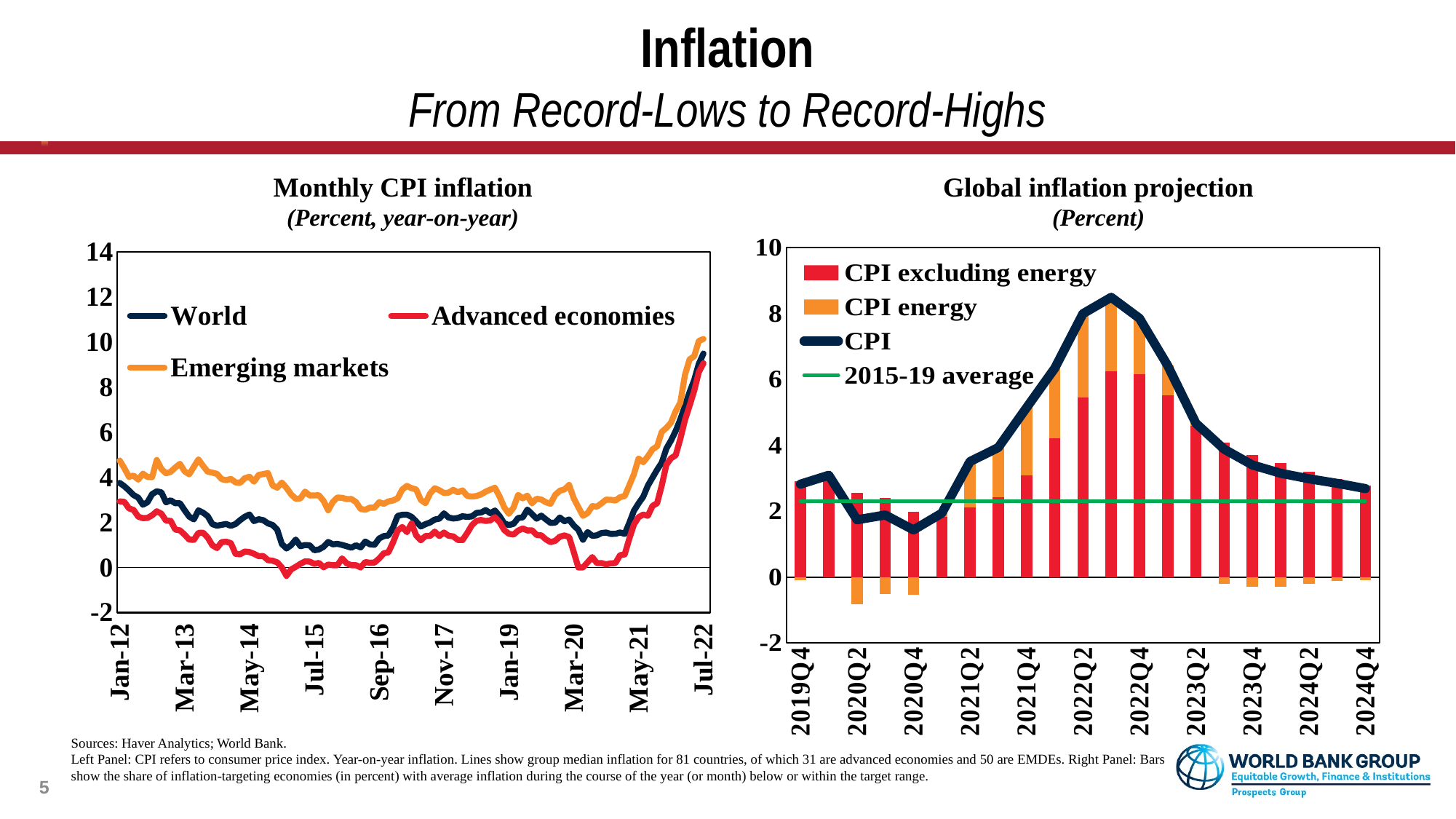
What kind of chart is the left chart, 'Monthly CPI inflation'? line chart In the left chart, 'Monthly CPI inflation', do the lines rise or fall between May-21 and Jul-22? rise In the right chart, 'Global inflation projection', is the peak of the CPI line greater or less than 8? greater In the left chart, 'Monthly CPI inflation', which series is highest at Jan-12? Emerging markets In the left chart, 'Monthly CPI inflation', which series is lowest at Jan-12? Advanced economies In the right chart, 'Global inflation projection', what colour represents CPI energy? orange How many series does the legend of the left chart, 'Monthly CPI inflation', list? 3 How many entries does the legend of the right chart, 'Global inflation projection', list? 4 In the left chart, 'Monthly CPI inflation', is the value for Emerging markets at Jan-12 greater or less than 4? greater In the left chart, 'Monthly CPI inflation', is the value for World at Jul-22 greater or less than 8? greater In the right chart, 'Global inflation projection', does the CPI line rise or fall between 2022Q4 and 2024Q4? fall